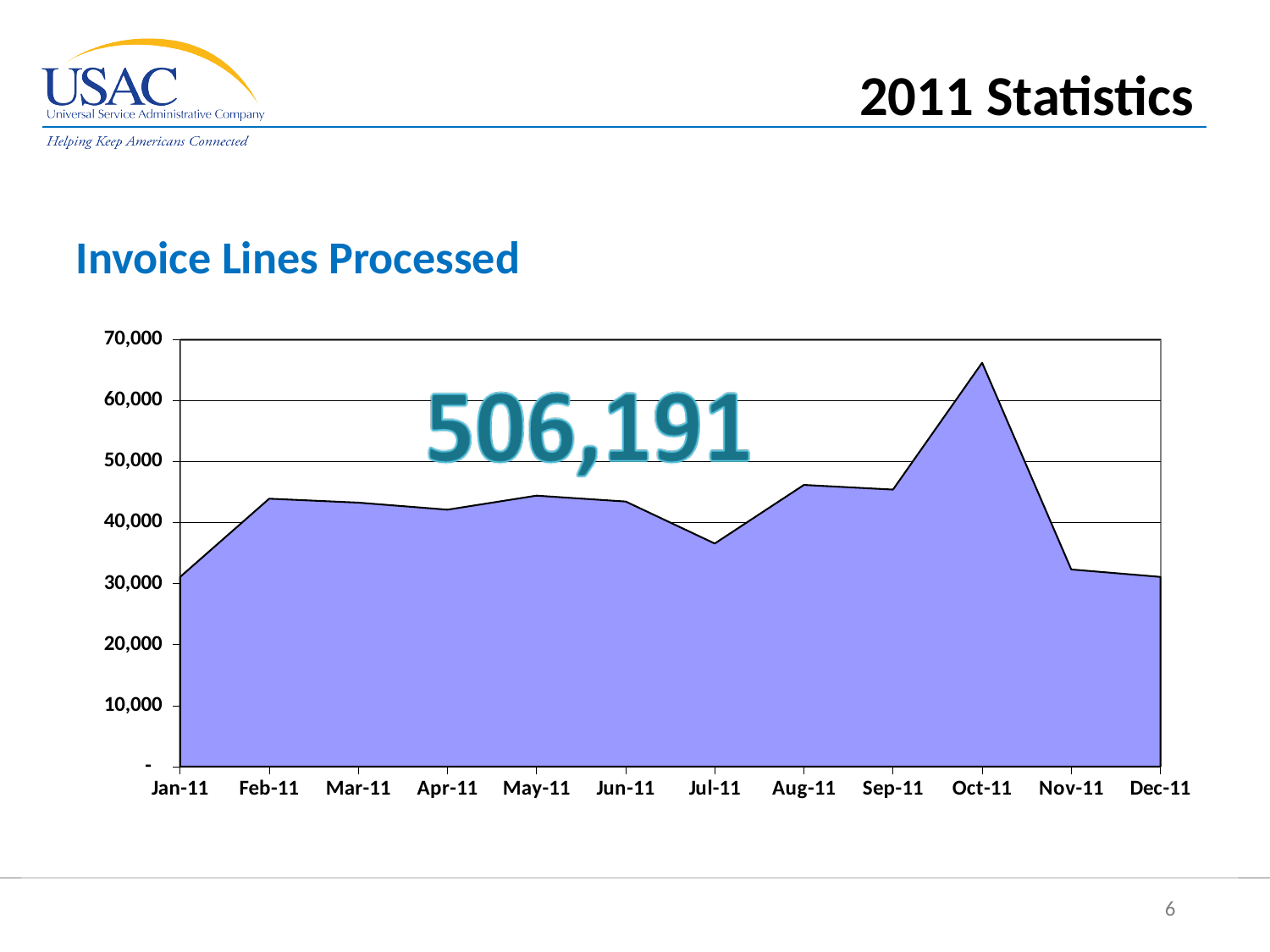
What kind of chart is shown on the slide? area chart Is the value for Jul-11 greater or less than 40,000? less Do the values rise or fall from Oct-11 to Nov-11? fall Is the value for Nov-11 greater or less than 40,000? less Which month has the highest number of invoice lines processed? Oct-11 Which is larger, the value for Oct-11 or the value for Jul-11? Oct-11 Which is larger, the value for Feb-11 or the value for Jan-11? Feb-11 How many months are plotted along the x axis? 12 Is the value for Feb-11 greater or less than 40,000? greater What large number is printed over the chart? 506,191